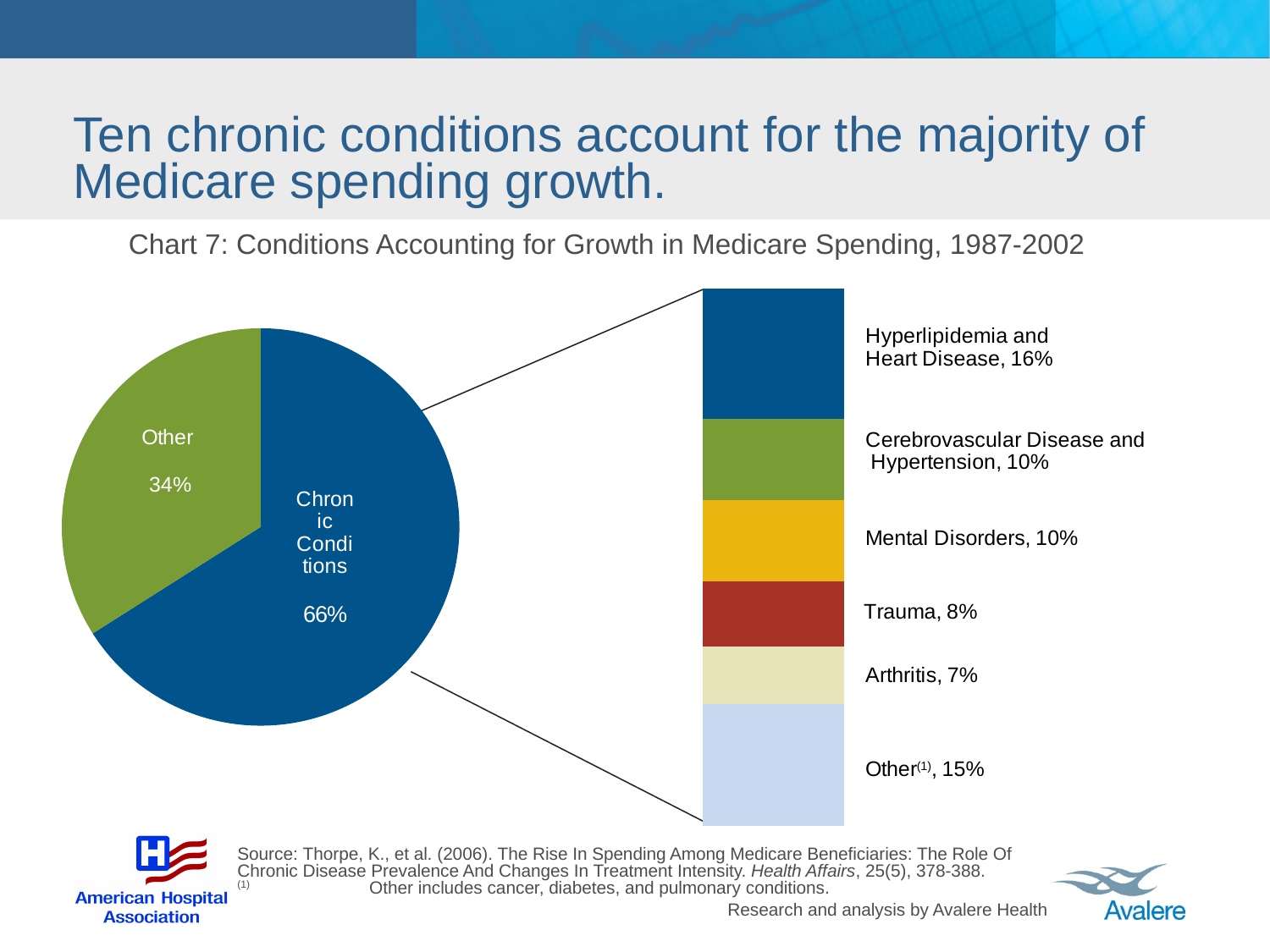
In the breakdown bar of chronic conditions, what is the value for Hyperlipidemia and Heart Disease? 16% How many segments make up the breakdown bar of chronic conditions? 6 In the breakdown bar of chronic conditions, what is the value for Arthritis? 7% In the breakdown bar of chronic conditions, what is the value for Trauma? 8% In the breakdown bar, which is larger: Mental Disorders or Trauma? Mental Disorders What is the difference between the Chronic Conditions slice and the Other slice in the pie chart? 32% In the breakdown bar of chronic conditions, which named condition category has the highest value? Hyperlipidemia and Heart Disease What is the title of the chart on the slide? Chart 7: Conditions Accounting for Growth in Medicare Spending, 1987-2002 In the pie chart, what share is labelled Other? 34% In the breakdown bar of chronic conditions, which category has the lowest value? Arthritis What is the total of all segments in the breakdown bar of chronic conditions? 66% In the pie chart, what share of Medicare spending growth is attributed to Chronic Conditions? 66%